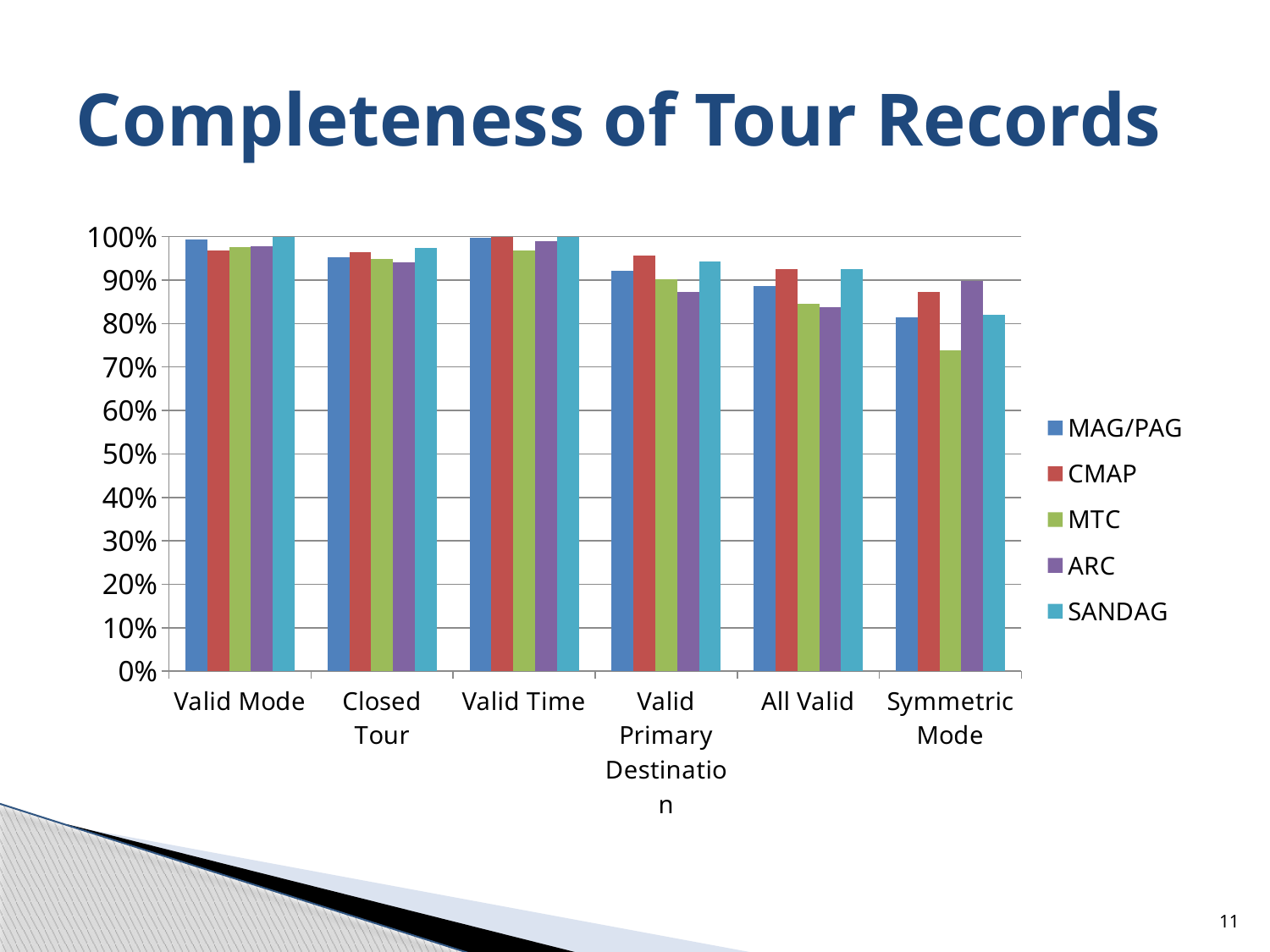
Is the SANDAG value for Valid Primary Destination greater or less than 90%? greater Which series has the lowest value for Symmetric Mode? MTC Is the MTC value for Symmetric Mode greater or less than 80%? less For All Valid, which is larger: the SANDAG value or the MAG/PAG value? SANDAG Is the ARC value for All Valid greater or less than 90%? less What is the title of the chart? Completeness of Tour Records Which series has the highest value for Symmetric Mode? ARC Do the MTC values generally rise or fall from Valid Mode to Symmetric Mode? fall How many series does the legend list? 5 What kind of chart is shown on the slide? bar chart How many categories are shown on the x axis? 6